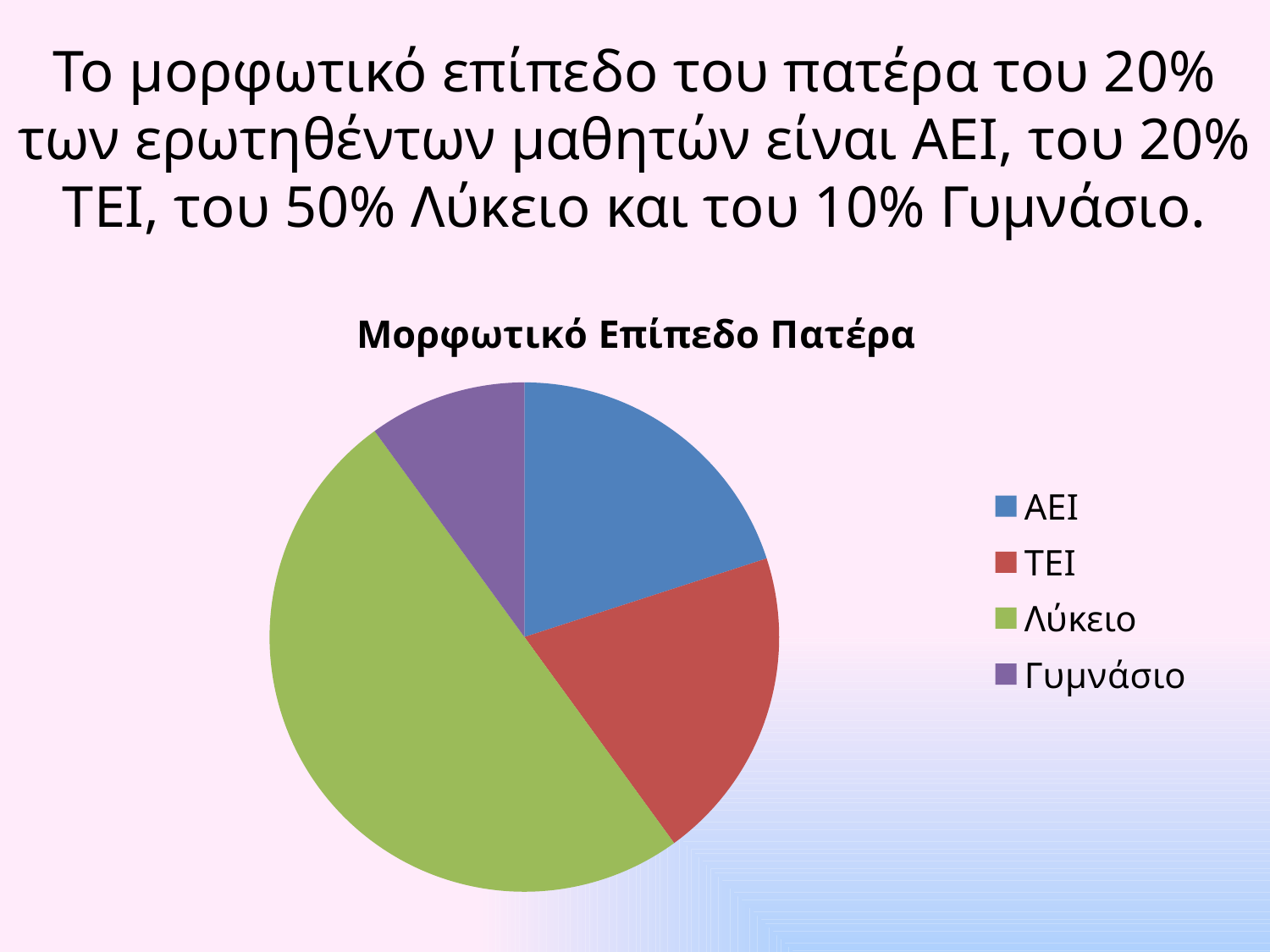
What colour is the Λύκειο slice? green What kind of chart is shown on the slide? pie chart What is the title of the chart? Μορφωτικό Επίπεδο Πατέρα How many slices does the pie chart have? 4 Which slice is larger, Λύκειο or ΑΕΙ? Λύκειο How many entries does the legend list? 4 Which category has the smallest slice of the pie? Γυμνάσιο Which category has the largest slice of the pie? Λύκειο Which slice is larger, ΤΕΙ or Γυμνάσιο? ΤΕΙ What share of the pie does Γυμνάσιο represent? 10% What share of the pie does Λύκειο represent? 50% What share of the pie does ΑΕΙ represent? 20%